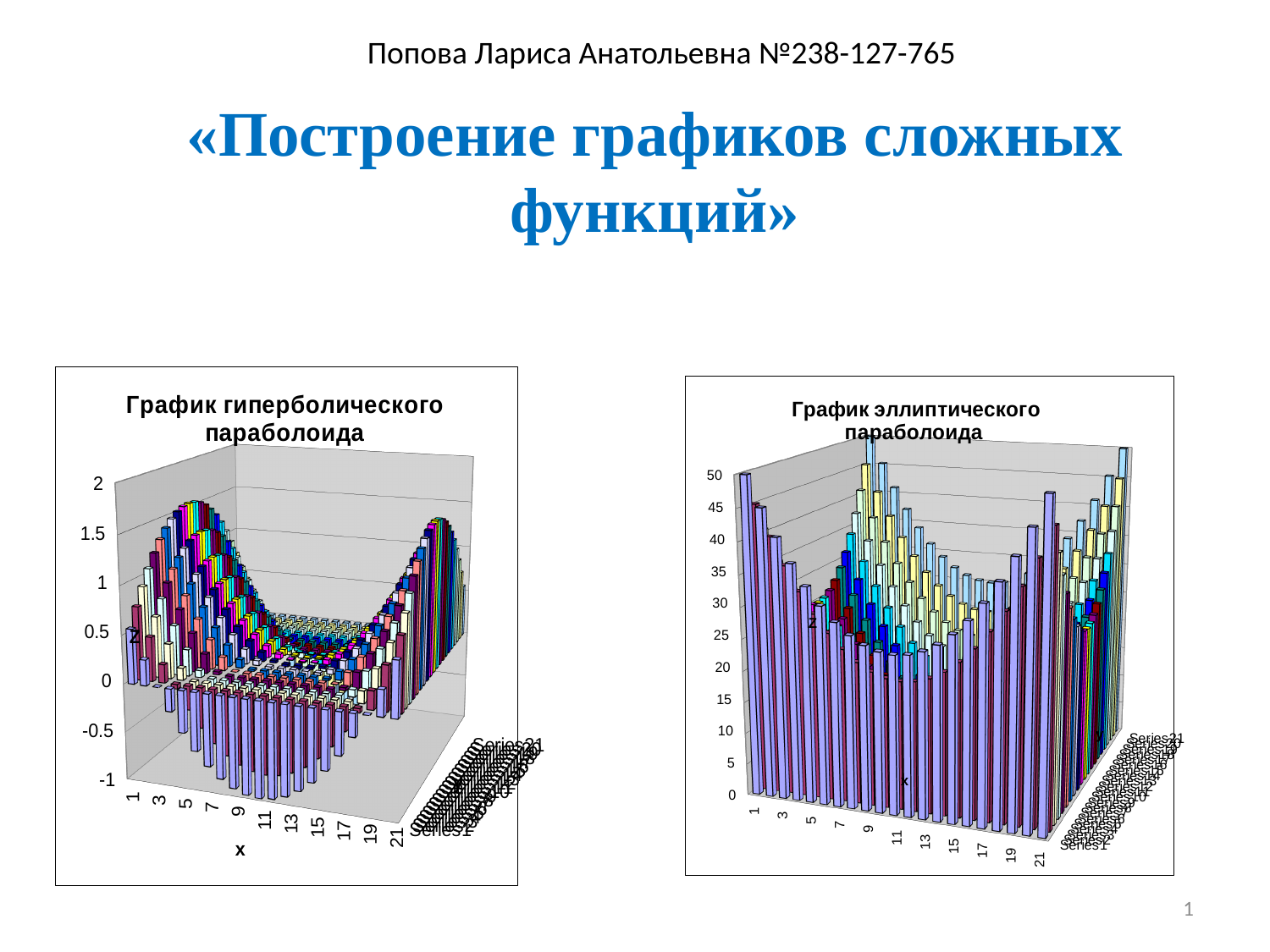
On the left chart, what is the lowest value shown on the vertical axis? -1 On the right chart, what is the highest value shown on the vertical axis? 50 On the left chart, what is the highest value shown on the vertical axis? 2 What is the title of the right chart? График эллиптического параболоида On the right chart, is the value of the front-row bar at x = 1 greater or less than 40? greater On the left chart, is the value of the front-row bar at x = 11 greater or less than 0? less What kind of chart is the right chart titled «График эллиптического параболоида»? 3D bar chart What is the title of the left chart? График гиперболического параболоида What kind of chart is the left chart titled «График гиперболического параболоида»? 3D bar chart On the right chart, what is the last x-axis tick label shown? 21